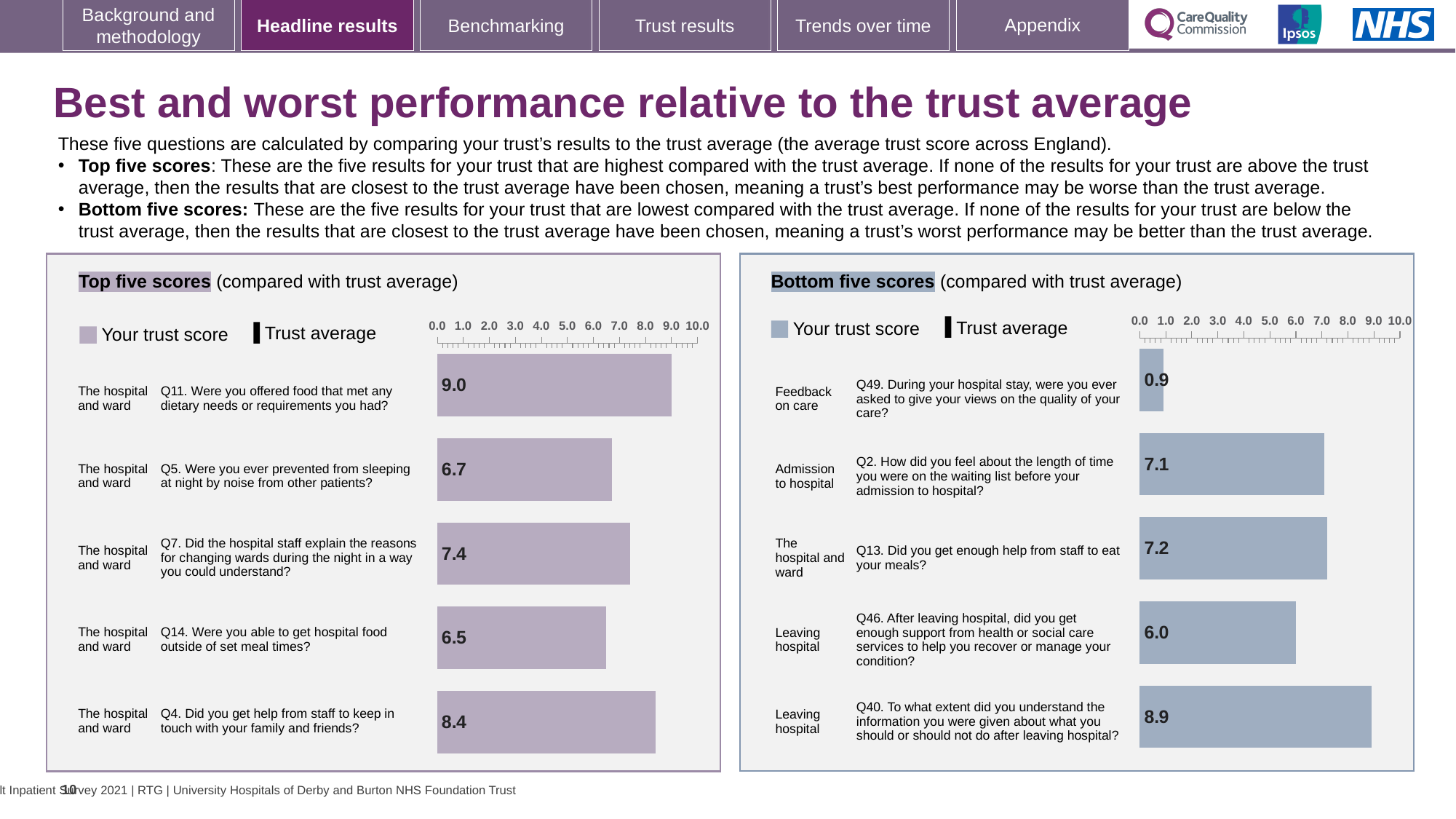
In the Bottom five scores chart, what is the trust score for Q46 (After leaving hospital, did you get enough support from health or social care services?)? 6.0 In the Top five scores chart, what is the difference between the trust scores for Q11 and Q14? 2.5 In the Bottom five scores chart, what is the difference between the trust scores for Q40 and Q49? 8.0 In the Bottom five scores chart, is the trust score for Q40 greater or less than 8.0? greater In the Top five scores chart, what is the trust score for Q11 (Were you offered food that met any dietary needs or requirements you had?)? 9.0 In the Bottom five scores chart, which question has the lowest trust score? Q49 In the Top five scores chart, which has the larger trust score, Q5 or Q4? Q4 What kind of chart is the Top five scores chart? Bar chart In the Bottom five scores chart, what is the trust score for Q49 (During your hospital stay, were you ever asked to give your views on the quality of your care?)? 0.9 In the Top five scores chart, what is the trust score for Q14 (Were you able to get hospital food outside of set meal times?)? 6.5 In the Top five scores chart, which question has the highest trust score? Q11 How many questions are plotted in the Bottom five scores chart? 5